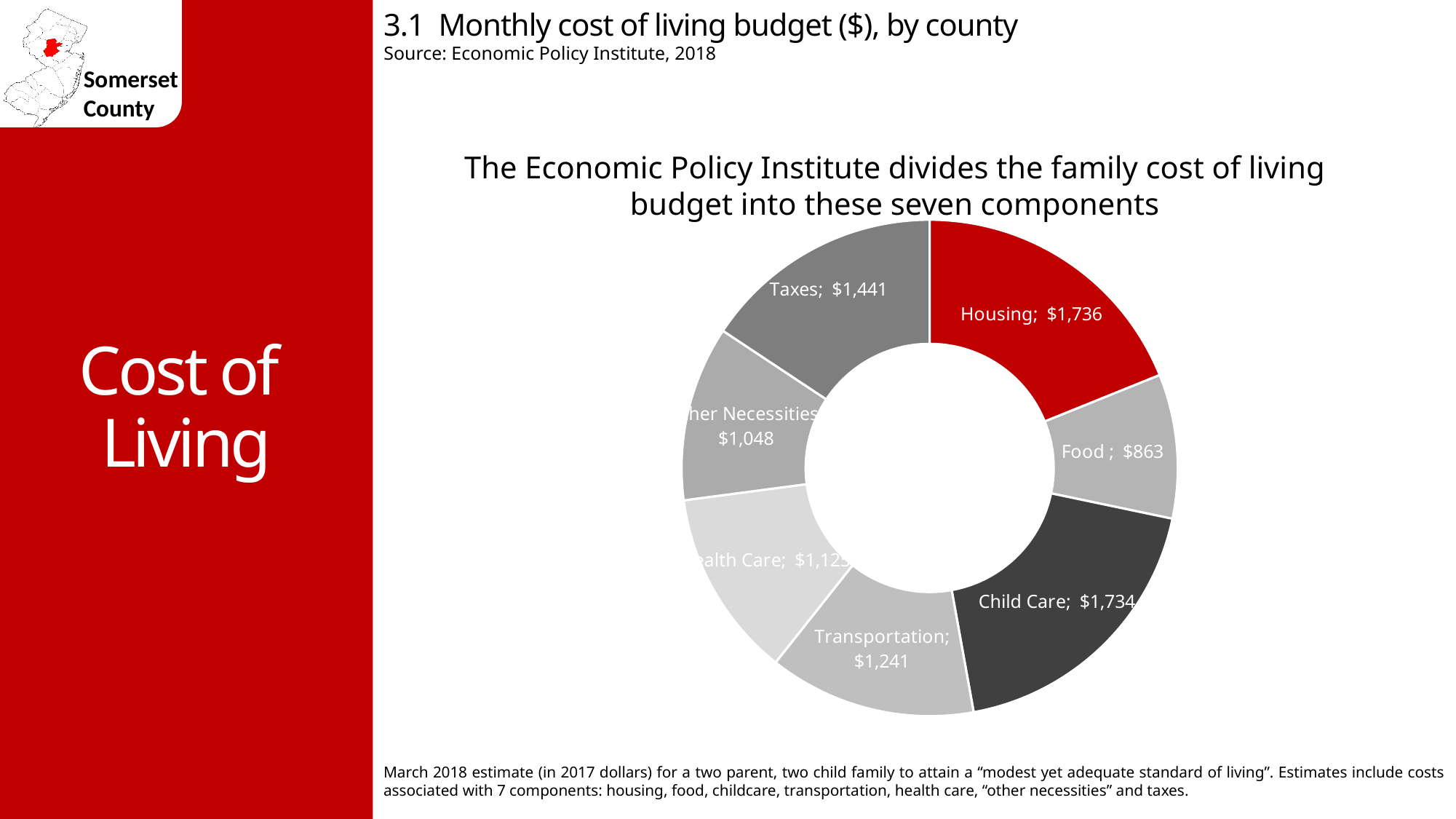
What is the monthly cost for Housing shown on the chart? $1,736 What kind of chart is shown on the slide? Pie (doughnut) chart How many components are shown in the chart? 7 Which component has the lowest monthly cost on the chart? Food Which is larger, the cost for Taxes or the cost for Transportation? Taxes What colour is the Housing slice of the chart? Red What is the monthly cost for Transportation shown on the chart? $1,241 What is the difference between the Transportation cost and the Food cost? $378 What is the monthly cost for Taxes shown on the chart? $1,441 What is the monthly cost for Child Care shown on the chart? $1,734 What is the difference between the Housing cost and the Taxes cost? $295 What is the monthly cost for Food shown on the chart? $863